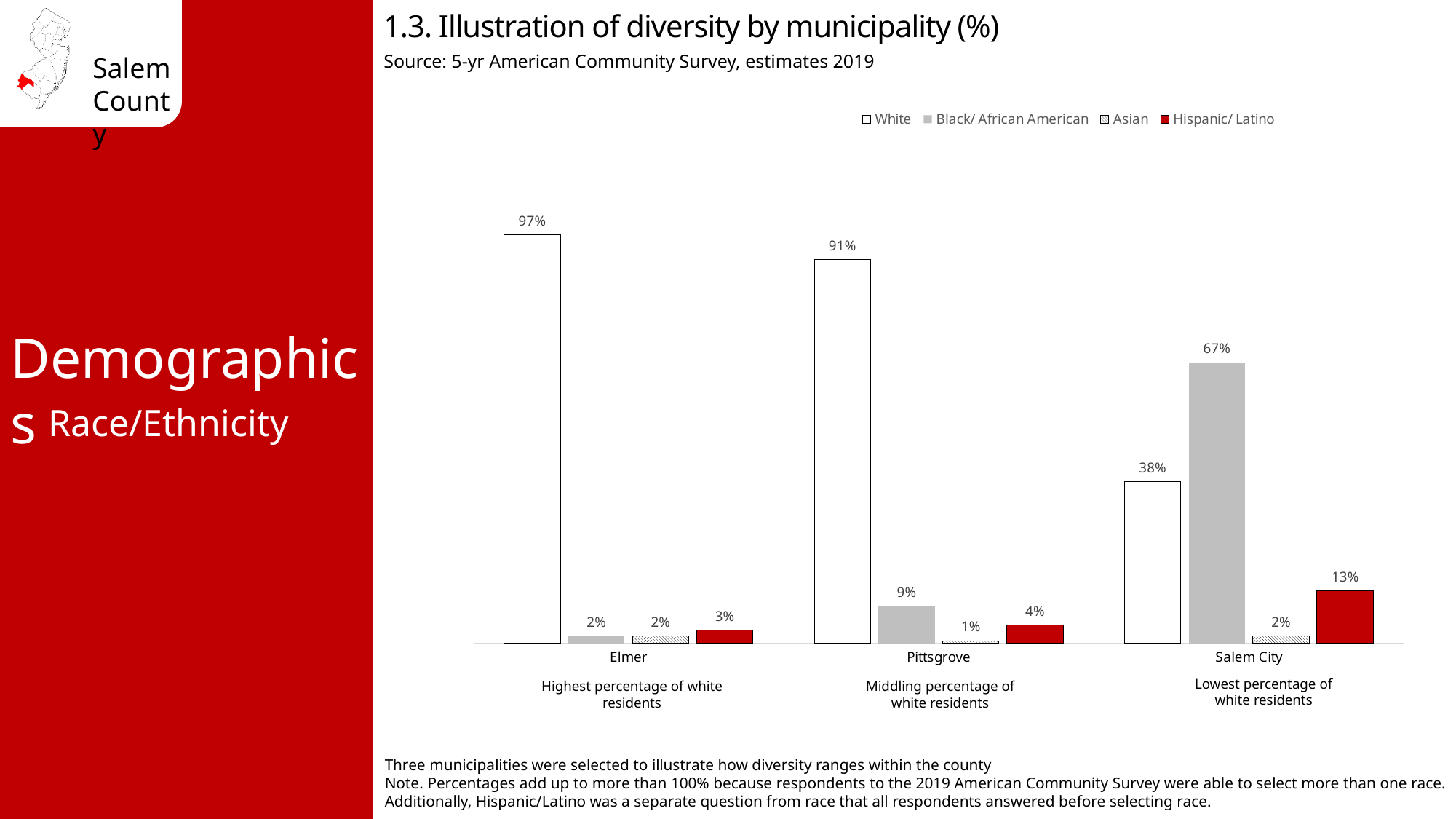
What is the Black/ African American percentage for Salem City? 67% Which series is shown in red in the legend? Hispanic/ Latino How many municipalities are shown on the chart? 3 Which municipality has the highest White percentage? Elmer How many series does the legend list? 4 What is the difference between the White percentage for Elmer and the White percentage for Salem City? 59% What is the White percentage for Elmer? 97% What is the Asian percentage for Pittsgrove? 1% Which municipality has the lowest White percentage? Salem City What kind of chart is shown on the slide? Bar chart Which is larger in Salem City: the White percentage or the Black/ African American percentage? Black/ African American What is the Hispanic/ Latino percentage for Pittsgrove? 4%